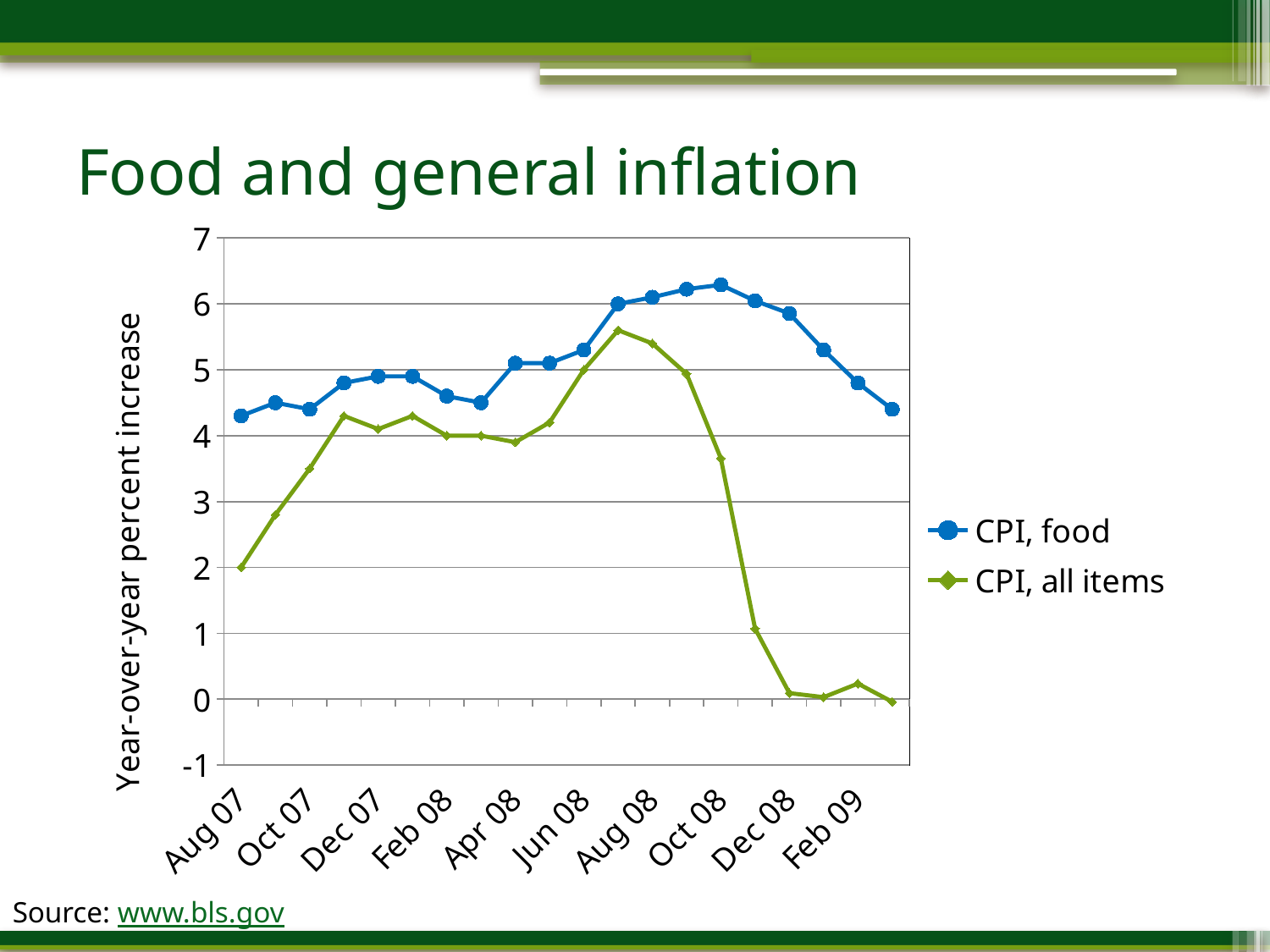
Is the value for CPI, all items in Feb 09 greater or less than 1? less How many series does the legend list? 2 How many month labels are shown on the x axis? 10 Is the value for CPI, food in Aug 07 greater or less than 4? greater In Aug 07, which series has the higher value, CPI, food or CPI, all items? CPI, food Does the CPI, all items series rise or fall between Oct 08 and Dec 08? Fall Is the value for CPI, all items in Aug 07 greater or less than 3? less What is the title of the vertical axis? Year-over-year percent increase What are the two series named in the legend? CPI, food and CPI, all items What kind of chart is shown on the slide? Line chart